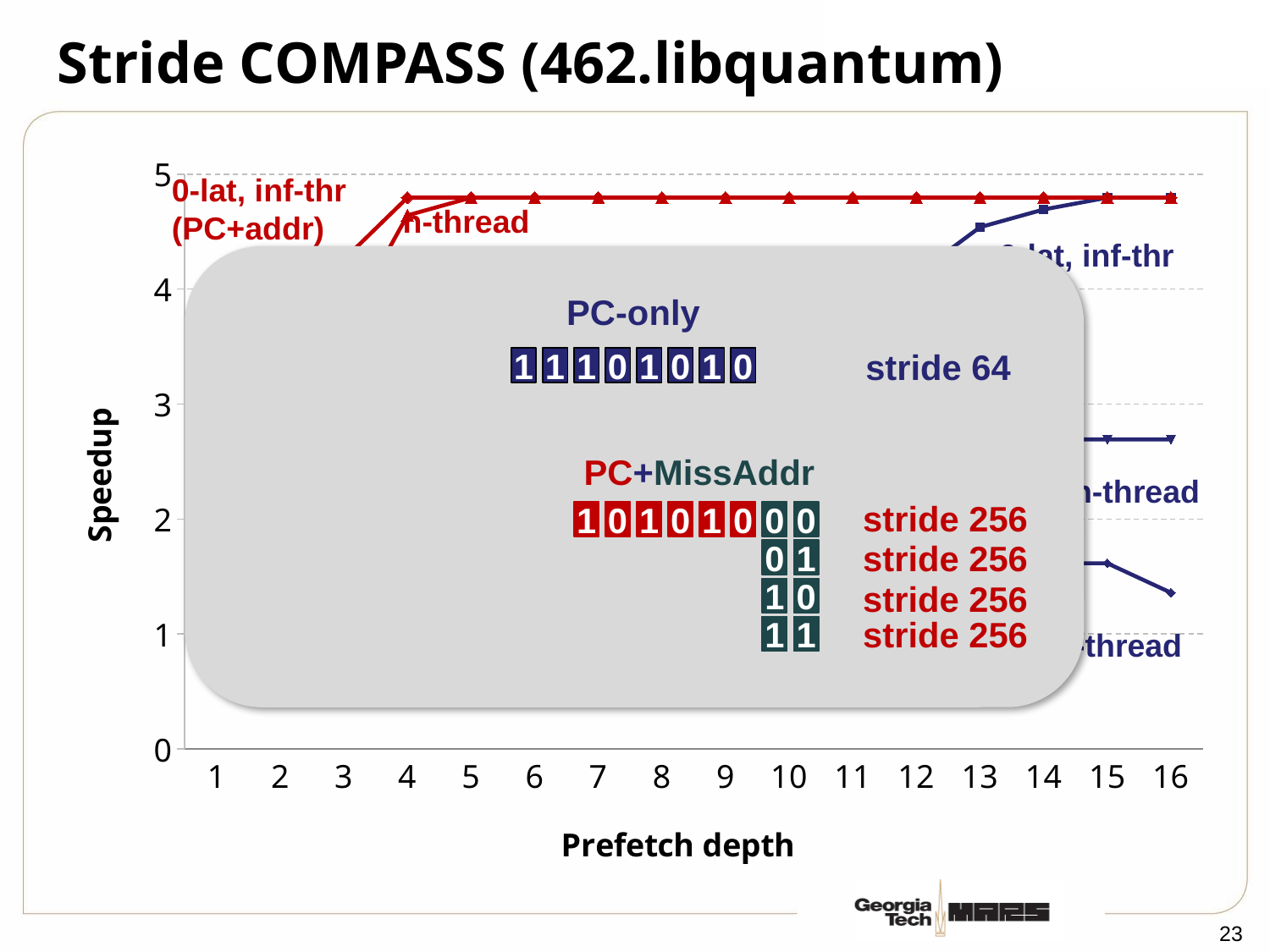
What is the highest value shown on the y axis? 5 Is the speedup of the lowest blue line at prefetch depth 16 greater or less than 1? greater How many prefetch depth values are marked along the x axis? 16 What is the title of the y axis? Speedup Does the lowest blue line rise or fall from prefetch depth 15 to 16? fall At prefetch depth 16, which is larger: the speedup of the red line or the speedup of the lowest blue line? the red line Is the speedup of the middle blue line at prefetch depth 16 greater or less than 3? less Is the speedup of the red line at prefetch depth 10 greater or less than 4? greater What is the title of the x axis? Prefetch depth Does the top blue line rise or fall from prefetch depth 13 to 15? rise What kind of chart is shown on the slide? line chart